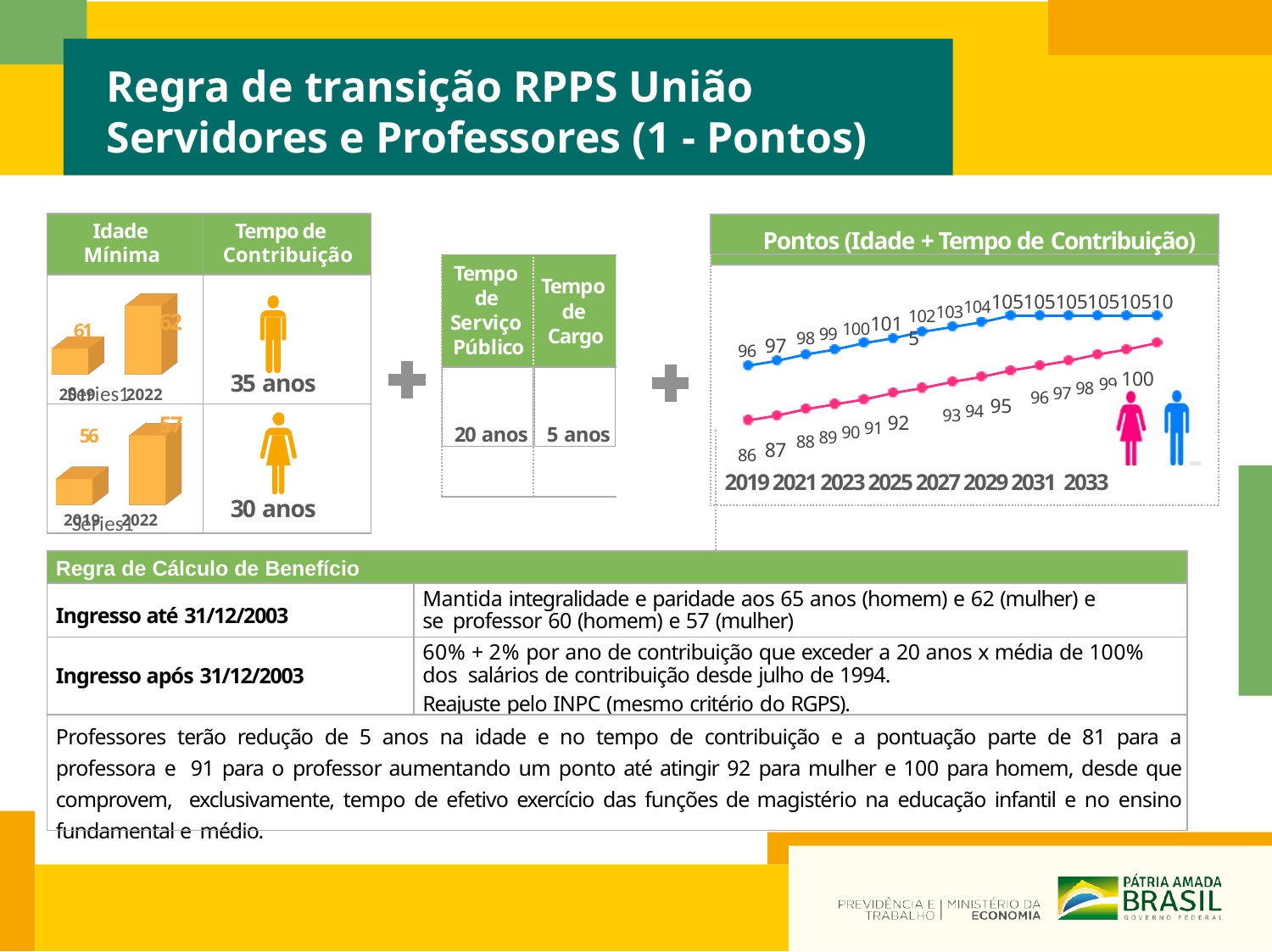
In the 'Pontos (Idade + Tempo de Contribuição)' chart, what is the value of the pink (lower) line in 2019? 86 In the 'Pontos (Idade + Tempo de Contribuição)' chart, what is the difference between the blue line and the pink line in 2019? 10 In the 'Pontos (Idade + Tempo de Contribuição)' chart, what is the final value of the pink line at the right end? 100 In the 'Pontos (Idade + Tempo de Contribuição)' chart, how many lines (series) are plotted? 2 In the 'Idade Mínima' bar chart for men (top left), what is the value for 2022? 62 In the 'Pontos (Idade + Tempo de Contribuição)' chart, does the pink line rise or fall from 2019 to 2033? rise In the 'Idade Mínima' bar charts, which is larger: the 2022 value for men or the 2022 value for women? men (62) In the 'Pontos (Idade + Tempo de Contribuição)' chart, what is the highest value reached by the blue line? 105 In the 'Idade Mínima' bar chart for women (bottom left), what is the value for 2019? 56 In the 'Pontos (Idade + Tempo de Contribuição)' chart, how many year labels are shown on the x axis? 8 In the 'Pontos (Idade + Tempo de Contribuição)' chart, what is the value of the blue (upper) line in 2019? 96 What kind of chart is the 'Pontos (Idade + Tempo de Contribuição)' chart? line chart